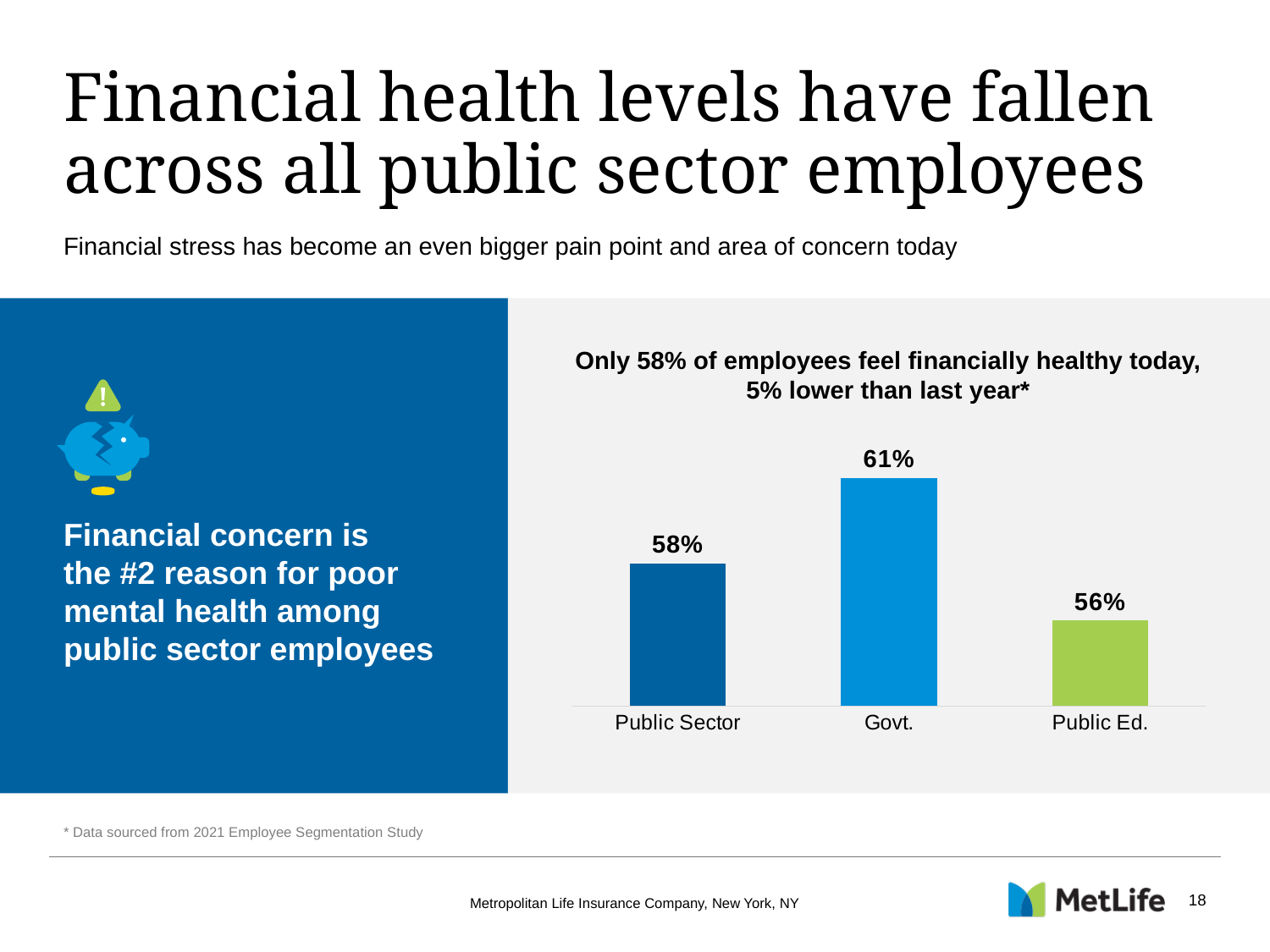
Which category has the lowest value? Public Ed. What is the title of the chart? Only 58% of employees feel financially healthy today, 5% lower than last year* What is the difference between the Govt. and Public Ed. values? 5% What percentage of Public Sector employees feel financially healthy? 58% How many categories are shown in the chart? 3 Which category has the highest value? Govt. What colour is the bar for Public Ed.? Green What is the value shown for Public Ed.? 56% What is the difference between the Govt. and Public Sector values? 3% What kind of chart is shown on the slide? Bar chart Which is larger, the value for Public Sector or the value for Public Ed.? Public Sector What is the value shown for Govt.? 61%